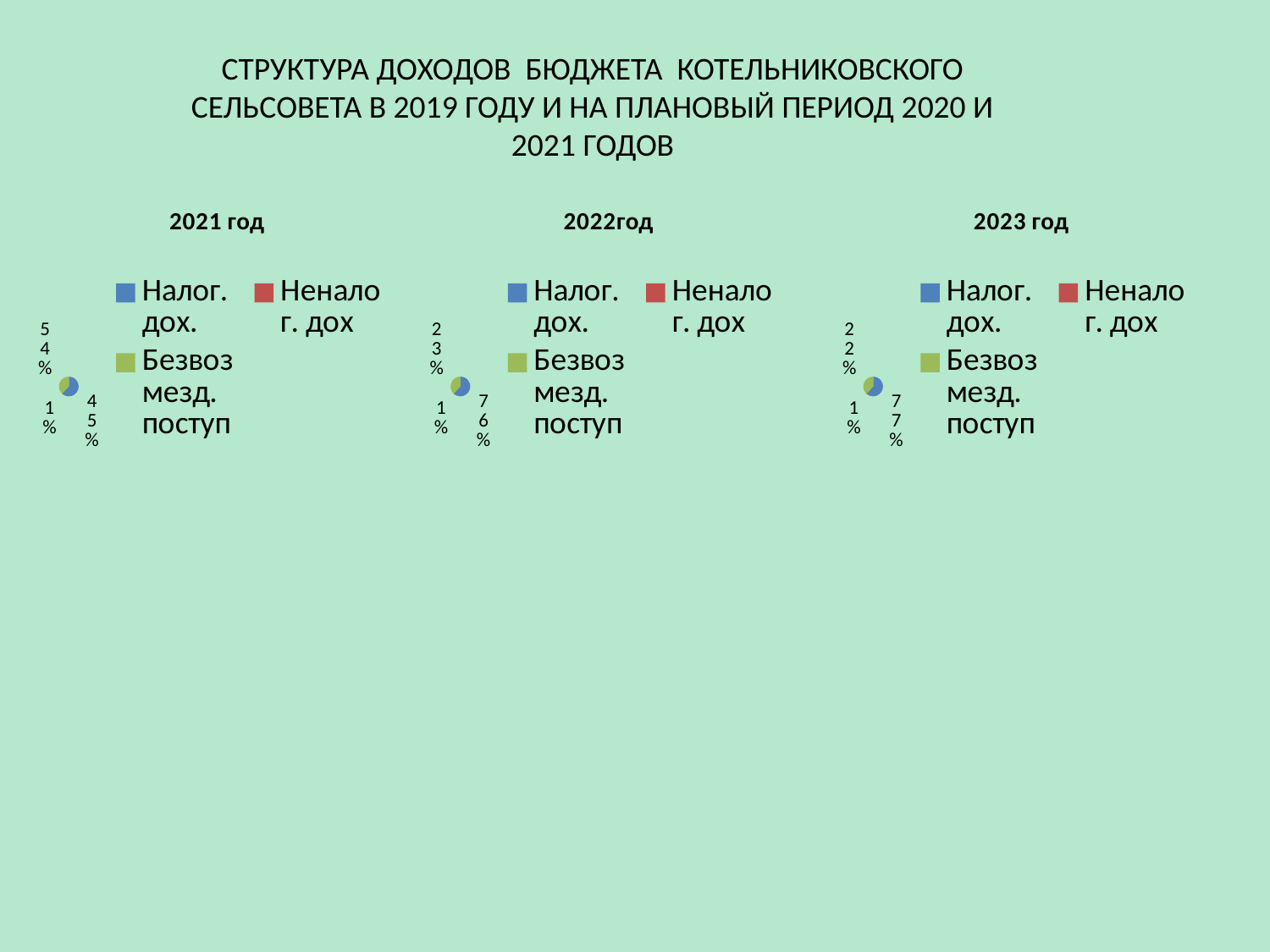
What is the largest percentage labelled on the 2021 год chart? 54% What are the three legend entries of the 2023 год chart? Налог. дох., Неналог. дох, Безвозмезд. поступ Which chart has a slice labelled 45%? 2021 год What is the largest percentage labelled on the 2022год chart? 76% What is the smallest percentage labelled on the 2023 год chart? 1% What kind of charts are shown on the slide? Pie charts What is the title of the chart on the right of the slide? 2023 год How many pie charts are on the slide? 3 What is the largest percentage labelled on the 2023 год chart? 77% Which chart has a slice labelled 23%? 2022год How many entries does the legend of the 2021 год chart list? 3 What is the smallest percentage labelled on the 2021 год chart? 1%